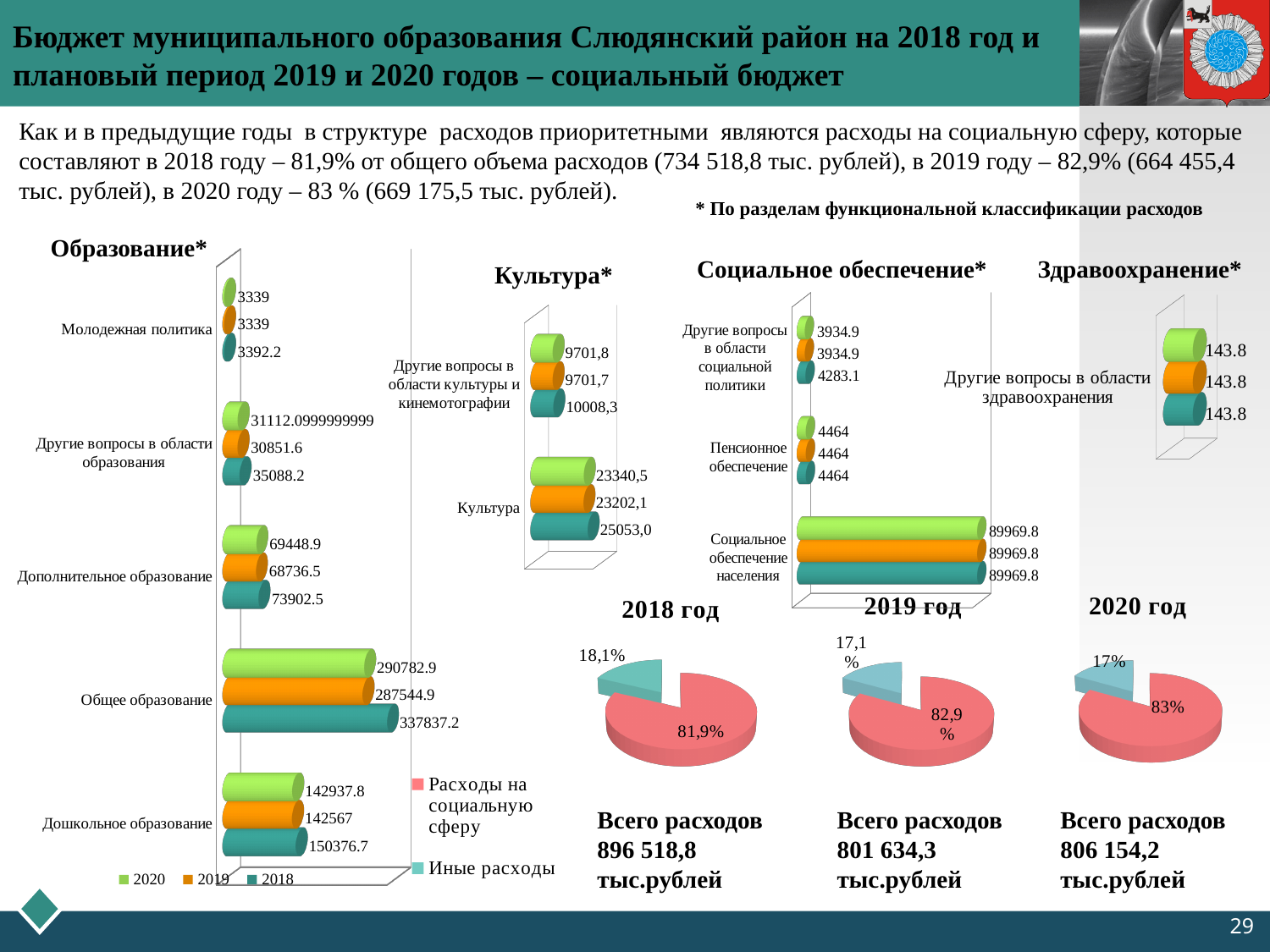
In the "2020 год" pie chart, what share is Иные расходы? 17% In the "Образование*" chart, how much larger is the 2018 value than the 2020 value for Дополнительное образование? 4453.6 In the "Культура*" chart, for the category Культура, which year has the larger value, 2018 or 2020? 2018 In the "Образование*" chart, what is the 2020 value for Дошкольное образование? 142937.8 In the "Социальное обеспечение*" chart, what is the 2018 value for Другие вопросы в области социальной политики? 4283.1 In the "Культура*" chart, what is the 2019 value for Культура? 23202,1 In the "Образование*" chart, which category has the highest 2018 value? Общее образование How many series does the legend of the "Образование*" chart list? 3 In the "2018 год" pie chart, what share is Расходы на социальную сферу? 81,9% In the "Здравоохранение*" chart, what is the 2020 value for Другие вопросы в области здравоохранения? 143.8 In the "Образование*" chart, what is the 2018 value for Общее образование? 337837.2 In the "Образование*" chart, which category has the lowest 2018 value? Молодежная политика